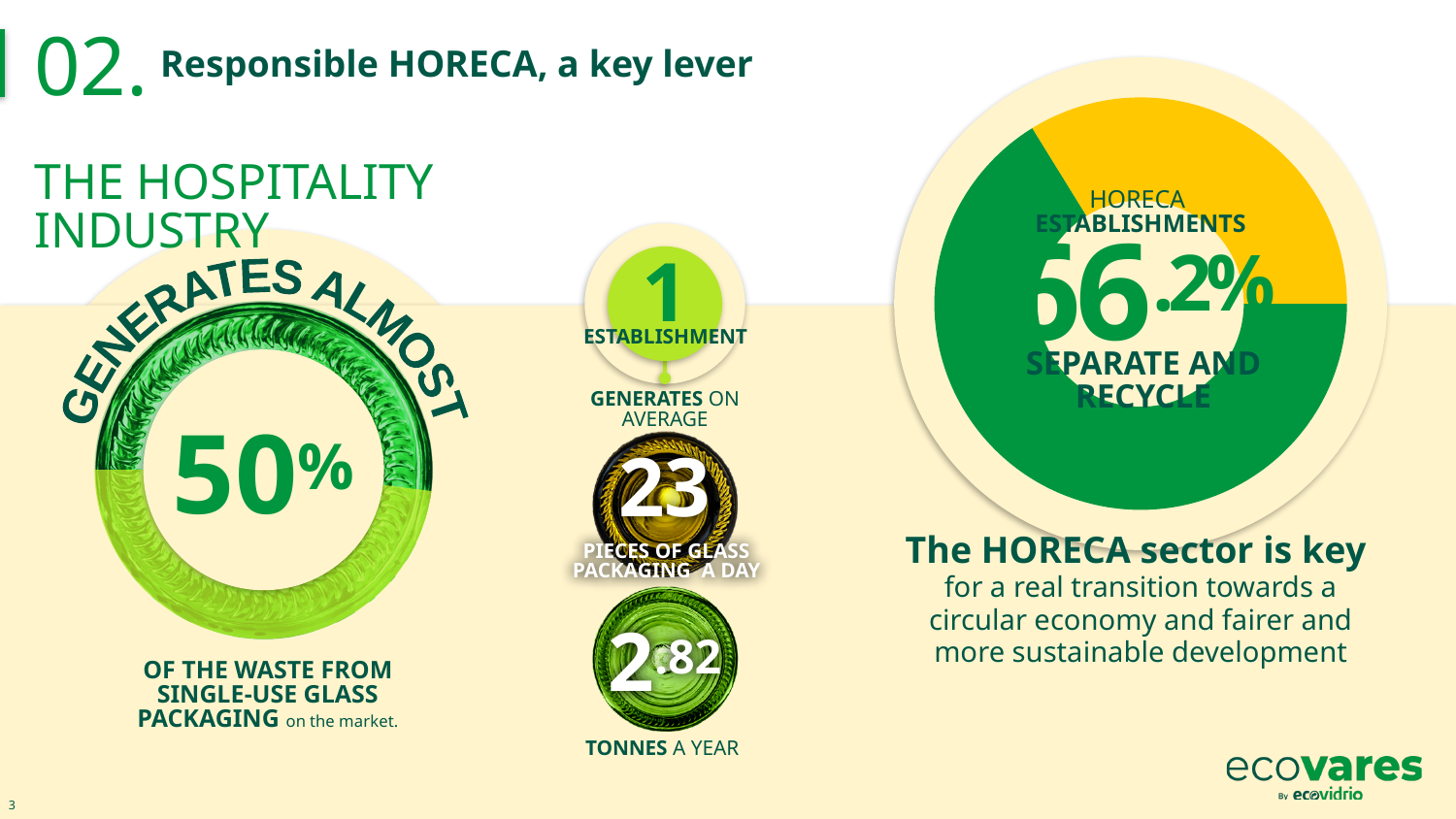
In the ring graphic on the left of the slide, is the percentage shown greater or less than 60%? less What text is written inside the HORECA ESTABLISHMENTS donut chart below the percentage? SEPARATE AND RECYCLE In the HORECA ESTABLISHMENTS donut chart, which segment is larger, the green one or the yellow one? The green one How many segments does the HORECA ESTABLISHMENTS donut chart have? 2 What kind of chart is shown at the top right of the slide, labelled HORECA ESTABLISHMENTS? Pie (donut) chart In the HORECA ESTABLISHMENTS donut chart, is the share of establishments that separate and recycle greater or less than 50%? greater In the ring graphic on the left of the slide, what percentage of the waste from single-use glass packaging on the market does the hospitality industry generate? 50% In the HORECA ESTABLISHMENTS donut chart, what percentage of HORECA establishments separate and recycle? 66.2% What colour is the segment representing HORECA establishments that separate and recycle in the donut chart? Green In the HORECA ESTABLISHMENTS donut chart, what share of the ring does the green segment represent? 66.2%